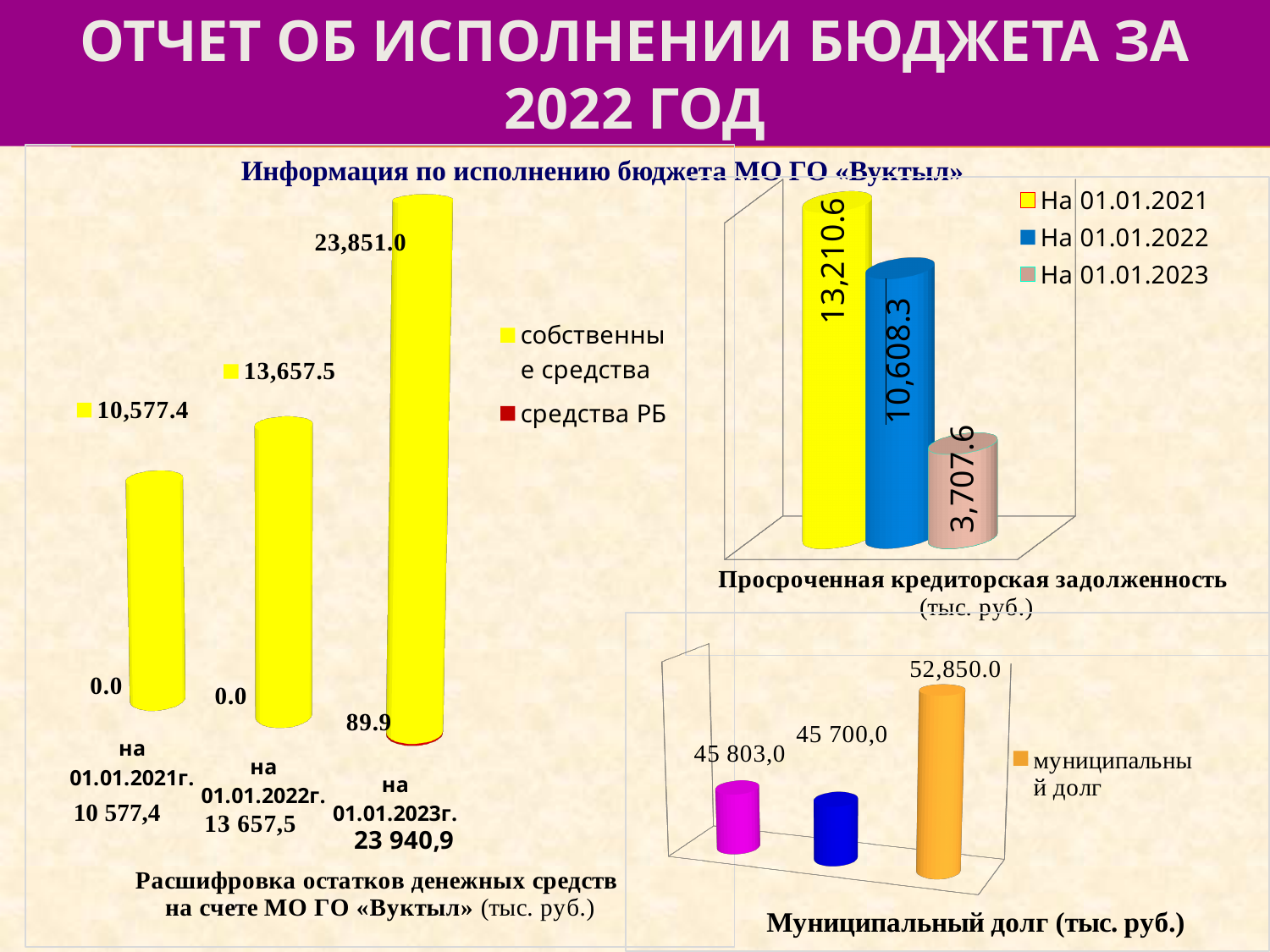
In the chart 'Просроченная кредиторская задолженность (тыс. руб.)', what is the value for 'На 01.01.2022'? 10,608.3 In the chart 'Расшифровка остатков денежных средств на счете МО ГО «Вуктыл»', how many series does the legend list? 2 In the chart 'Расшифровка остатков денежных средств на счете МО ГО «Вуктыл»', do the values of 'собственные средства' rise or fall from 01.01.2021 to 01.01.2023? rise In the chart 'Муниципальный долг (тыс. руб.)', how many bars are plotted? 3 In the chart 'Просроченная кредиторская задолженность (тыс. руб.)', which date has the lowest value? На 01.01.2023 In the chart 'Просроченная кредиторская задолженность (тыс. руб.)', do the values rise or fall from 01.01.2021 to 01.01.2023? fall In the chart 'Расшифровка остатков денежных средств на счете МО ГО «Вуктыл»', what is the value of 'средства РБ' for 'на 01.01.2023г.'? 89.9 In the chart 'Расшифровка остатков денежных средств на счете МО ГО «Вуктыл»', what is the value of 'собственные средства' for 'на 01.01.2021г.'? 10,577.4 In the chart 'Просроченная кредиторская задолженность (тыс. руб.)', what is the difference between the values for 'На 01.01.2021' and 'На 01.01.2023'? 9,503.0 In the chart 'Расшифровка остатков денежных средств на счете МО ГО «Вуктыл»', what is the value of 'собственные средства' for 'на 01.01.2023г.'? 23,851.0 In the chart 'Муниципальный долг (тыс. руб.)', what is the highest value shown? 52,850.0 What kind of chart is 'Муниципальный долг (тыс. руб.)'? bar chart